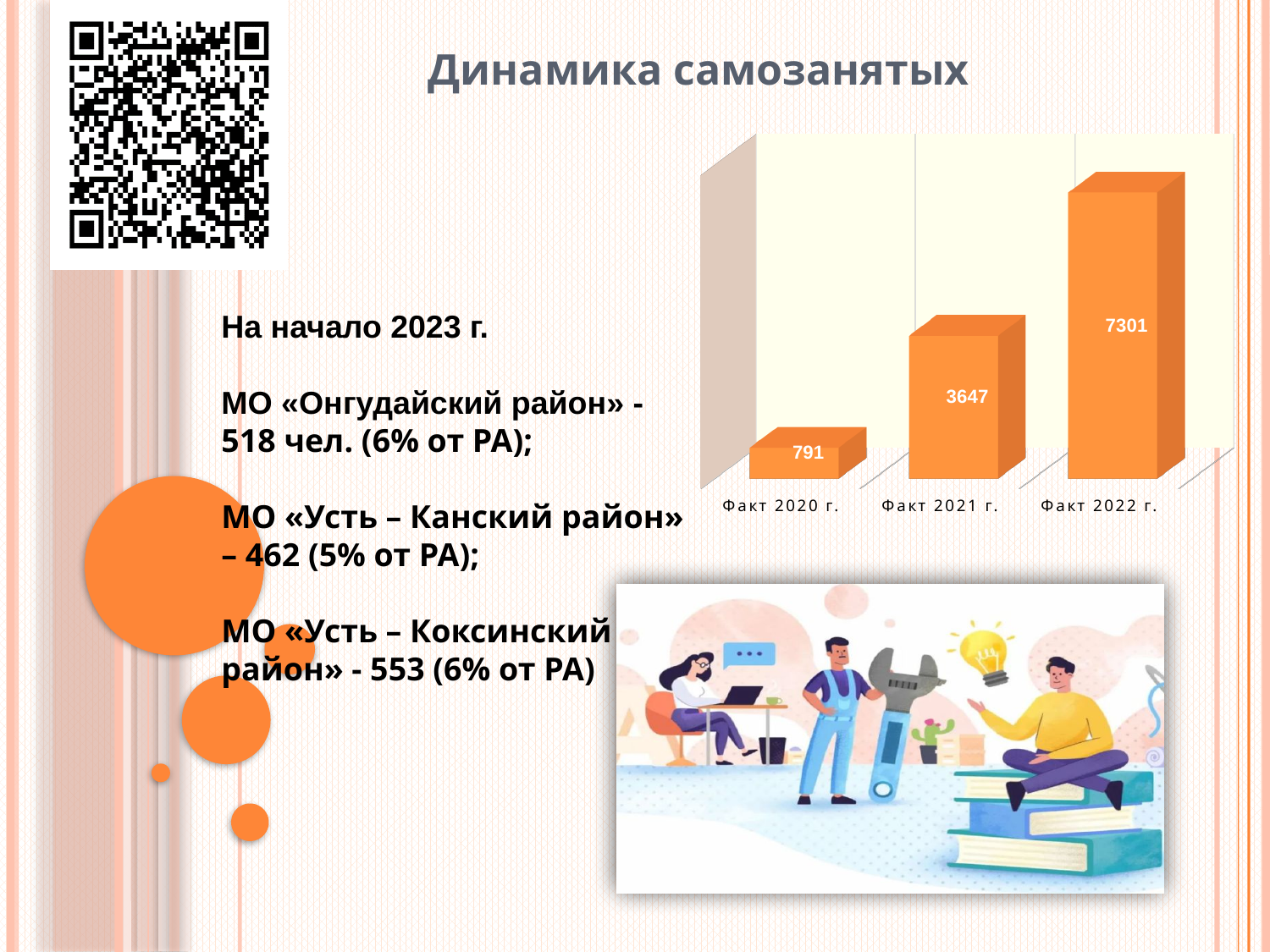
Do the values rise or fall from Факт 2020 г. to Факт 2022 г.? rise What is the difference between the values for Факт 2022 г. and Факт 2021 г.? 3654 Which category has the lowest value? Факт 2020 г. How many categories are shown in the chart? 3 Which is larger, the value for Факт 2021 г. or Факт 2020 г.? Факт 2021 г. What is the value for Факт 2020 г.? 791 What is the value for Факт 2021 г.? 3647 What is the title of the slide containing the chart? Динамика самозанятых What is the value for Факт 2022 г.? 7301 What kind of chart is shown on the slide? bar chart Which category has the highest value? Факт 2022 г. What is the difference between the values for Факт 2021 г. and Факт 2020 г.? 2856